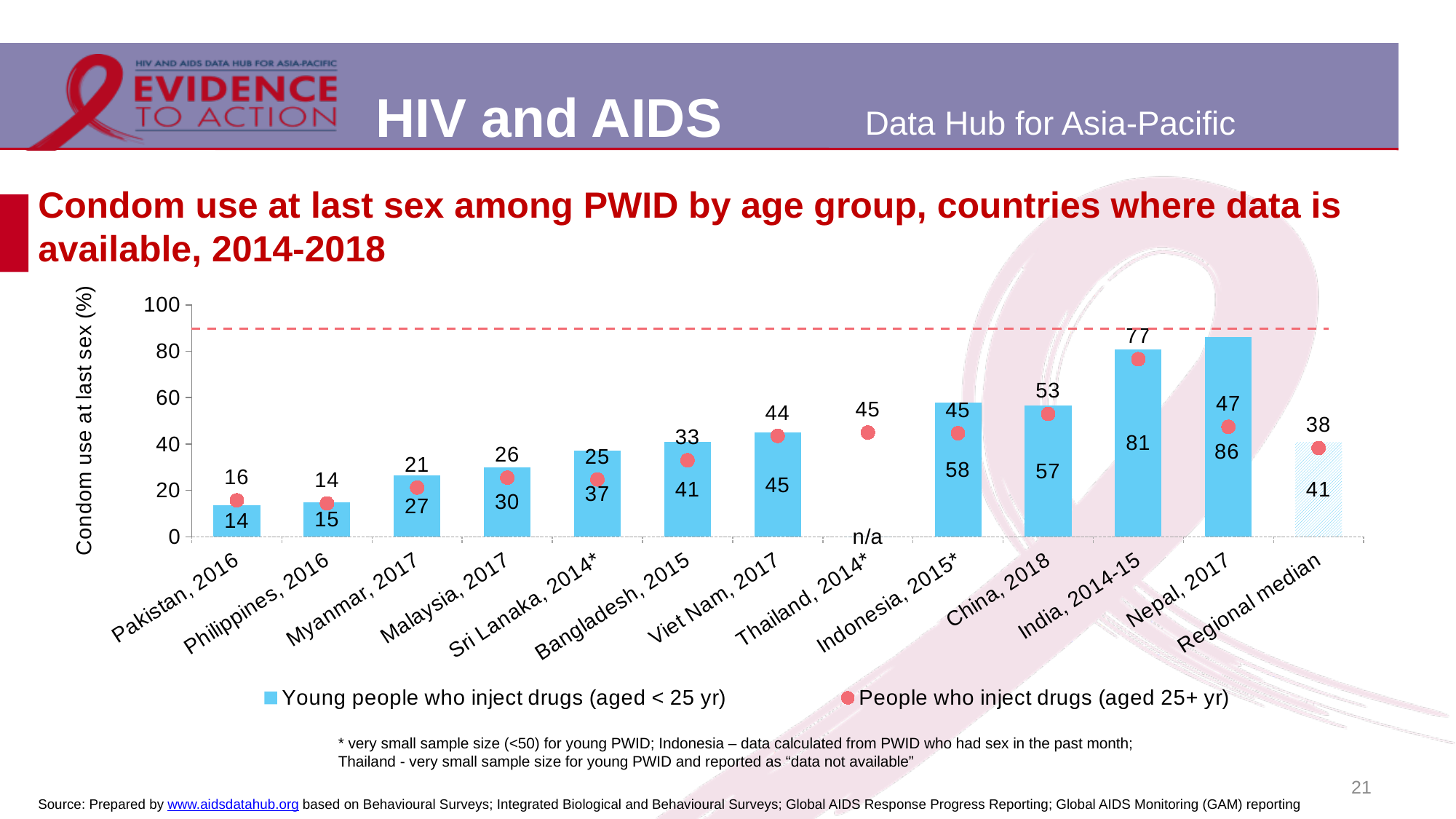
What is the value for people who inject drugs (aged 25+ yr) in India, 2014-15? 77 For Sri Lanka, 2014*, which is larger: the value for young people who inject drugs (aged < 25 yr) or the value for people who inject drugs (aged 25+ yr)? Young people who inject drugs (aged < 25 yr) Which country has the highest value for people who inject drugs (aged 25+ yr)? India, 2014-15 Which country has the highest value for young people who inject drugs (aged < 25 yr)? Nepal, 2017 How many categories are shown on the x axis of the chart? 13 What is the regional median for people who inject drugs (aged 25+ yr)? 38 How many series does the legend list? 2 What is the difference between the young PWID (aged < 25 yr) value and the PWID (aged 25+ yr) value for Nepal, 2017? 39 What is the label of the y axis? Condom use at last sex (%) Which country has the lowest value for young people who inject drugs (aged < 25 yr)? Pakistan, 2016 What is the value for young people who inject drugs (aged < 25 yr) in Thailand, 2014*? n/a What is the value for young people who inject drugs (aged < 25 yr) in Nepal, 2017? 86